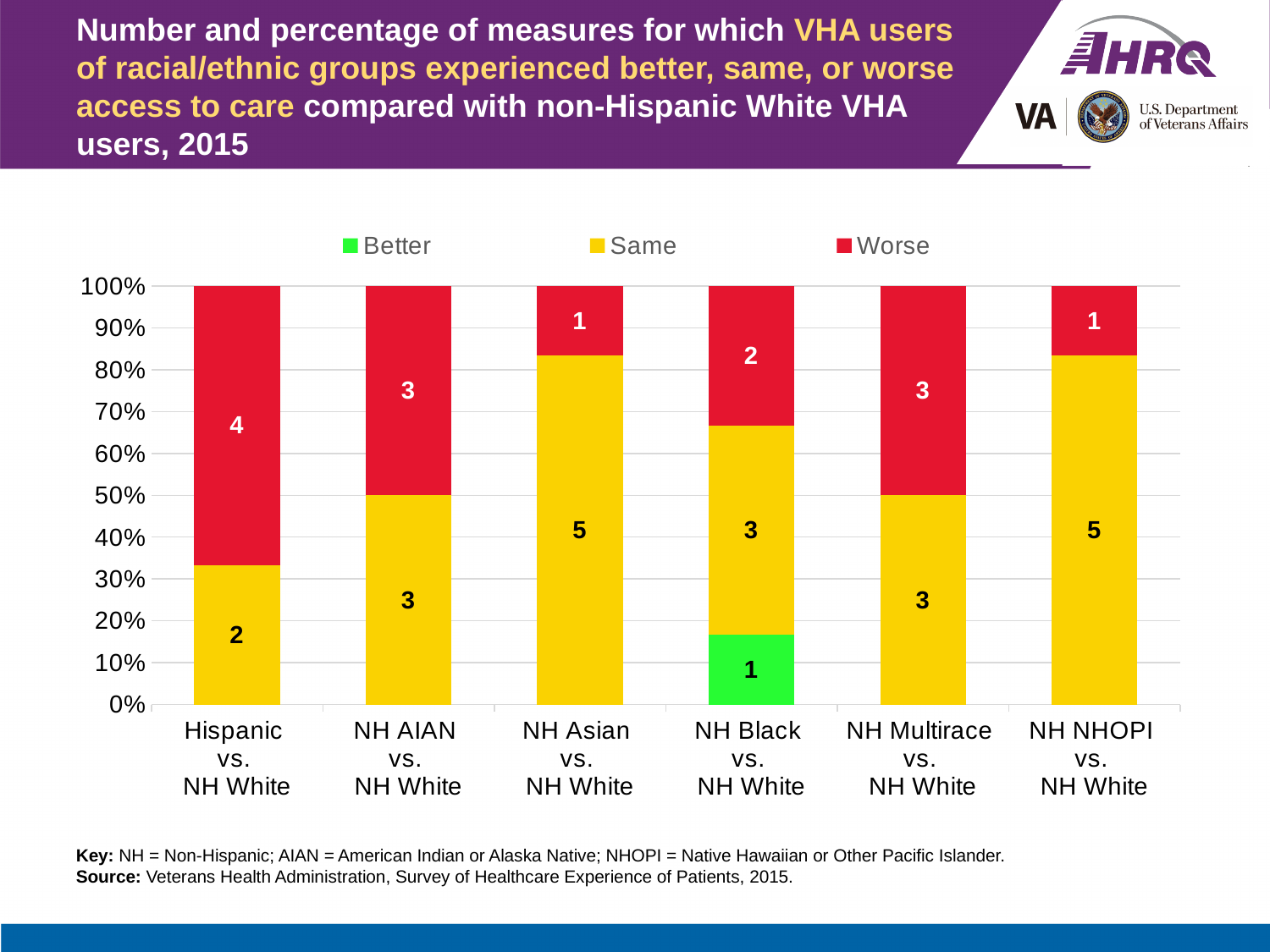
How many measures were 'Worse' for NH NHOPI vs. NH White? 1 How many series does the legend list? 3 How many measures were 'Worse' for Hispanic vs. NH White? 4 How many measures were 'Same' for NH Asian vs. NH White? 5 How many group comparisons are shown on the x axis? 6 What kind of chart is shown on the slide? Stacked bar chart Which group comparison is the only one with a 'Better' measure? NH Black vs. NH White Which group comparison has the highest number of 'Worse' measures? Hispanic vs. NH White Which has more 'Same' measures: NH AIAN vs. NH White or NH NHOPI vs. NH White? NH NHOPI vs. NH White What is the total number of measures in the NH Black vs. NH White bar? 6 What is the difference between the number of 'Worse' measures for Hispanic vs. NH White and for NH Asian vs. NH White? 3 How many measures were 'Better' for NH Black vs. NH White? 1